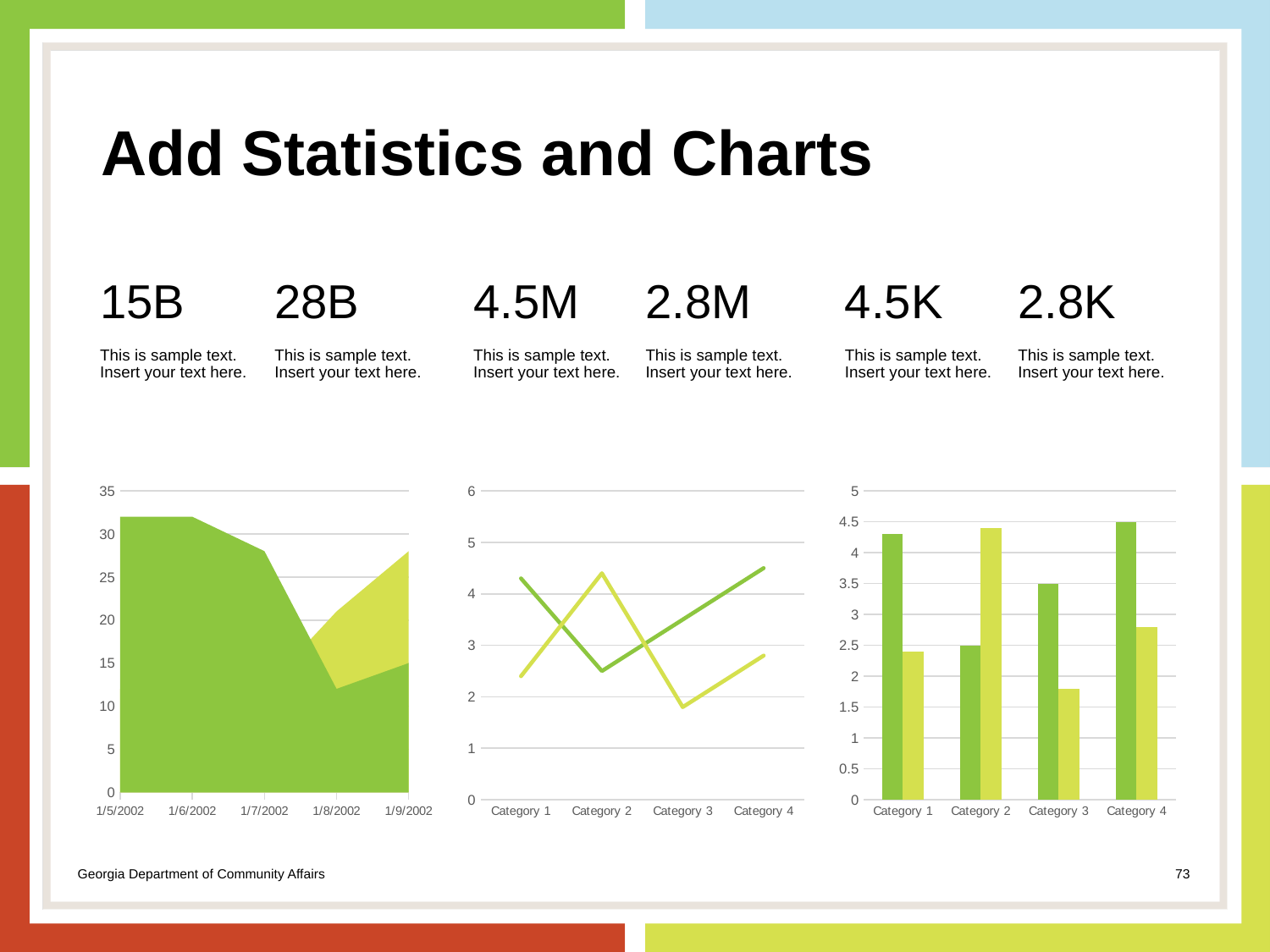
In the right bar chart, which category has the lowest light green bar? Category 3 In the middle line chart, is the value of the dark green line at Category 2 greater or less than 3? less In the left area chart, does the dark green series generally rise or fall from 1/5/2002 to 1/9/2002? Fall What kind of chart is the chart on the right of the slide? Bar chart In the middle line chart, is the value of the light green line at Category 2 greater or less than 4? greater In the left area chart, is the value of the dark green series at 1/5/2002 greater or less than 30? greater In the right bar chart, which category has the highest light green bar? Category 2 What kind of chart is the chart on the left of the slide? Area chart In the middle line chart, how many categories are shown on the x axis? 4 What kind of chart is the chart in the middle of the slide? Line chart In the left area chart, how many dates are shown on the x axis? 5